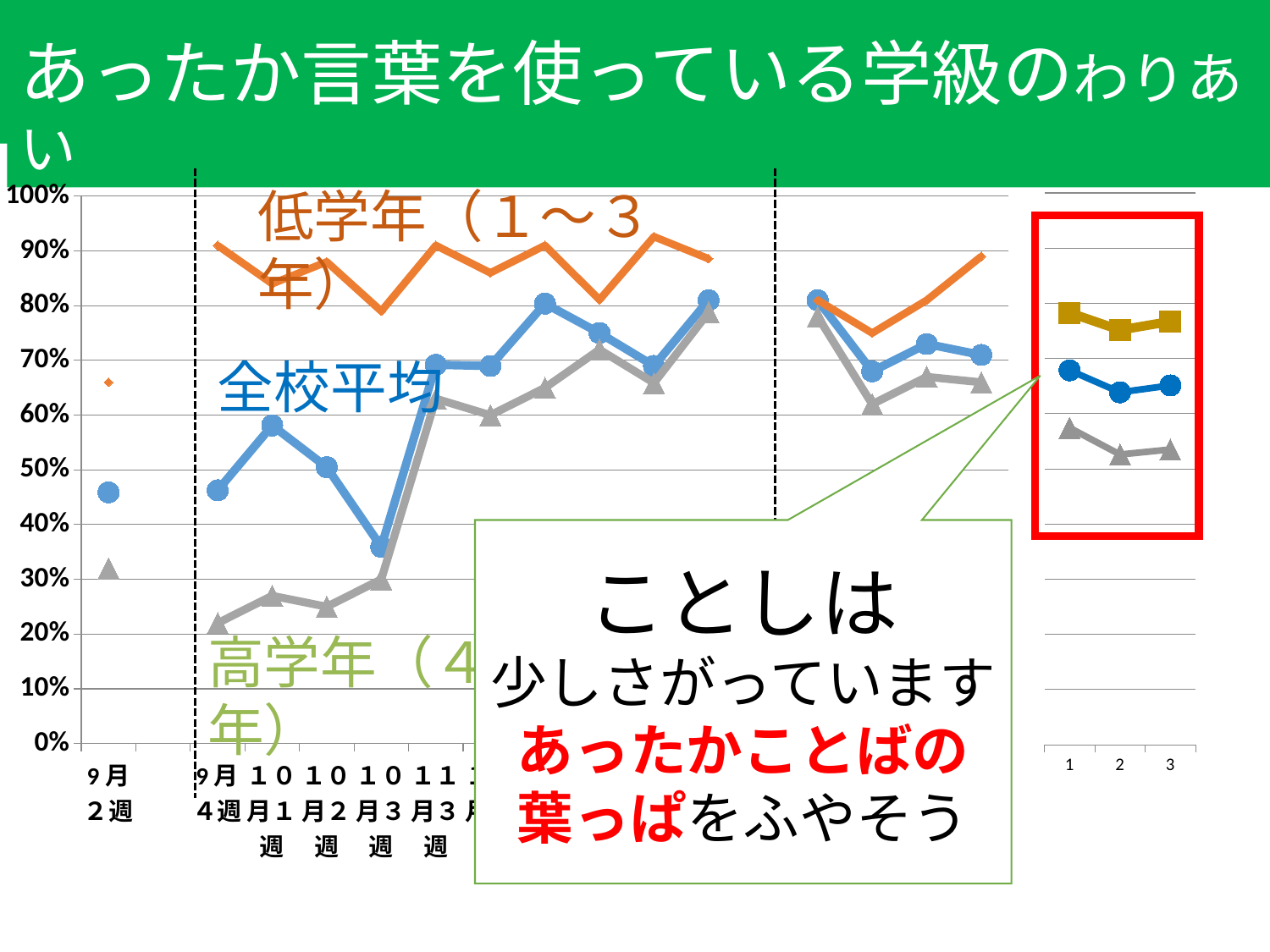
What kind of chart is the main chart on the slide? line chart In the main chart, is the value for 高学年（4～6年） at 9月4週 greater or less than 30%? less In the main chart, does the 全校平均 line rise or fall from 9月4週 to 10月1週? rise In the main chart, at 9月2週, which is larger: the value for 低学年（1～3年） or the value for 高学年（4～6年）? 低学年（1～3年） In the main chart, is the value for 低学年（1～3年） at 9月4週 greater or less than 80%? greater In the main chart, is the value for 全校平均 at 9月2週 greater or less than 50%? less What colour is the line for 全校平均 in the main chart? blue In the main chart, which series is plotted lowest across the weeks? 高学年（4～6年） How many points are plotted on the x axis of the small inset chart inside the red box? 3 In the main chart, does the 全校平均 line rise or fall from 10月1週 to 10月3週? fall In the main chart, which series is plotted highest across the weeks: 低学年（1～3年）, 全校平均, or 高学年（4～6年）? 低学年（1～3年）